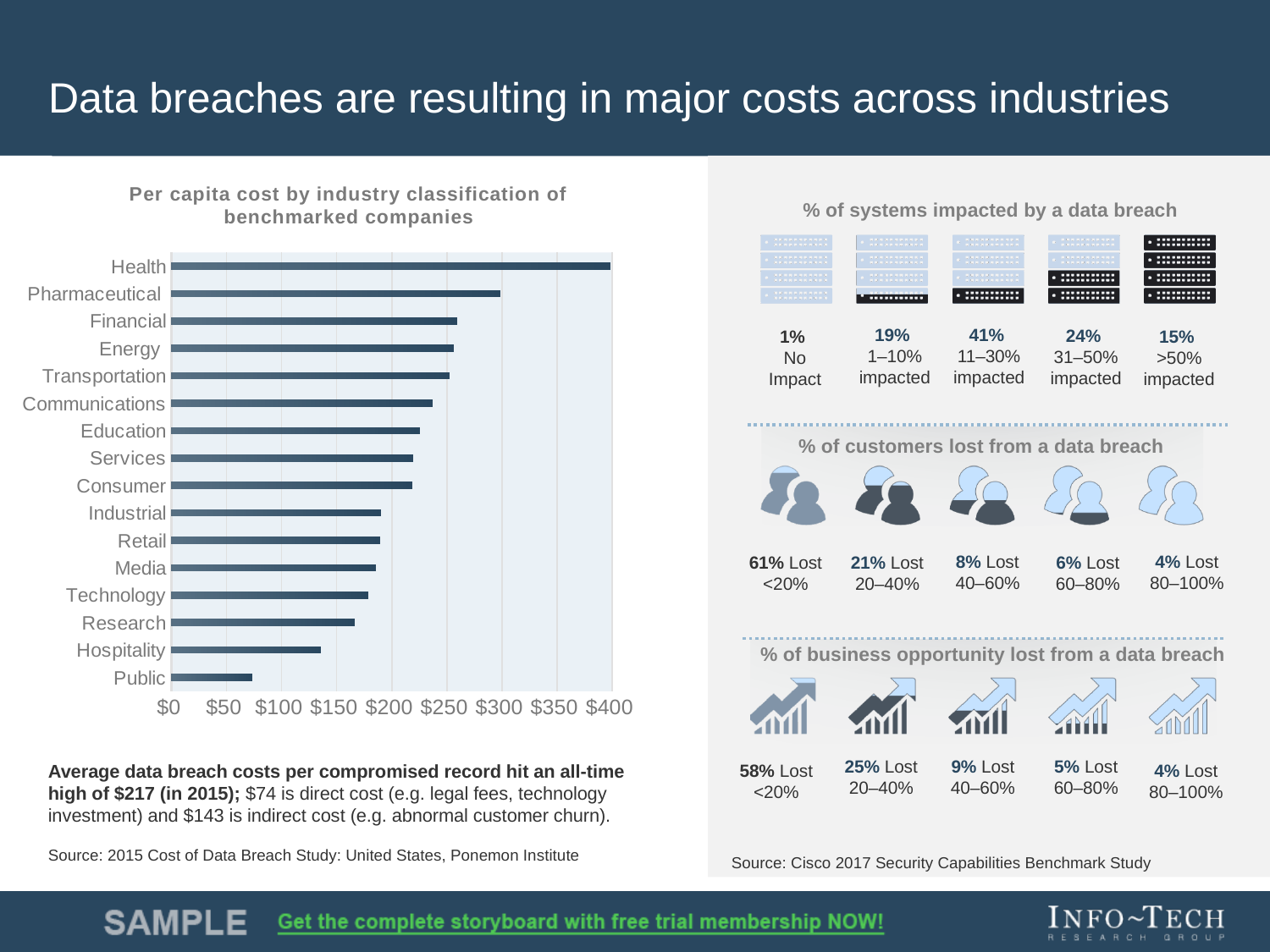
In the 'Per capita cost by industry classification of benchmarked companies' chart, is the value for Industrial greater or less than $200? less In the 'Per capita cost by industry classification of benchmarked companies' chart, which industry has the lowest per capita cost? Public What type of chart is the 'Per capita cost by industry classification of benchmarked companies' chart? bar chart In the 'Per capita cost by industry classification of benchmarked companies' chart, is the value for Hospitality greater or less than $150? less In the 'Per capita cost by industry classification of benchmarked companies' chart, do the bar values increase or decrease going from the top category to the bottom category? decrease In the 'Per capita cost by industry classification of benchmarked companies' chart, which has a higher per capita cost, Financial or Retail? Financial In the 'Per capita cost by industry classification of benchmarked companies' chart, is the value for Health greater or less than $350? greater What is the title of the bar chart on the left of the slide? Per capita cost by industry classification of benchmarked companies In the 'Per capita cost by industry classification of benchmarked companies' chart, which industry has the highest per capita cost? Health How many industries are shown in the 'Per capita cost by industry classification of benchmarked companies' chart? 16